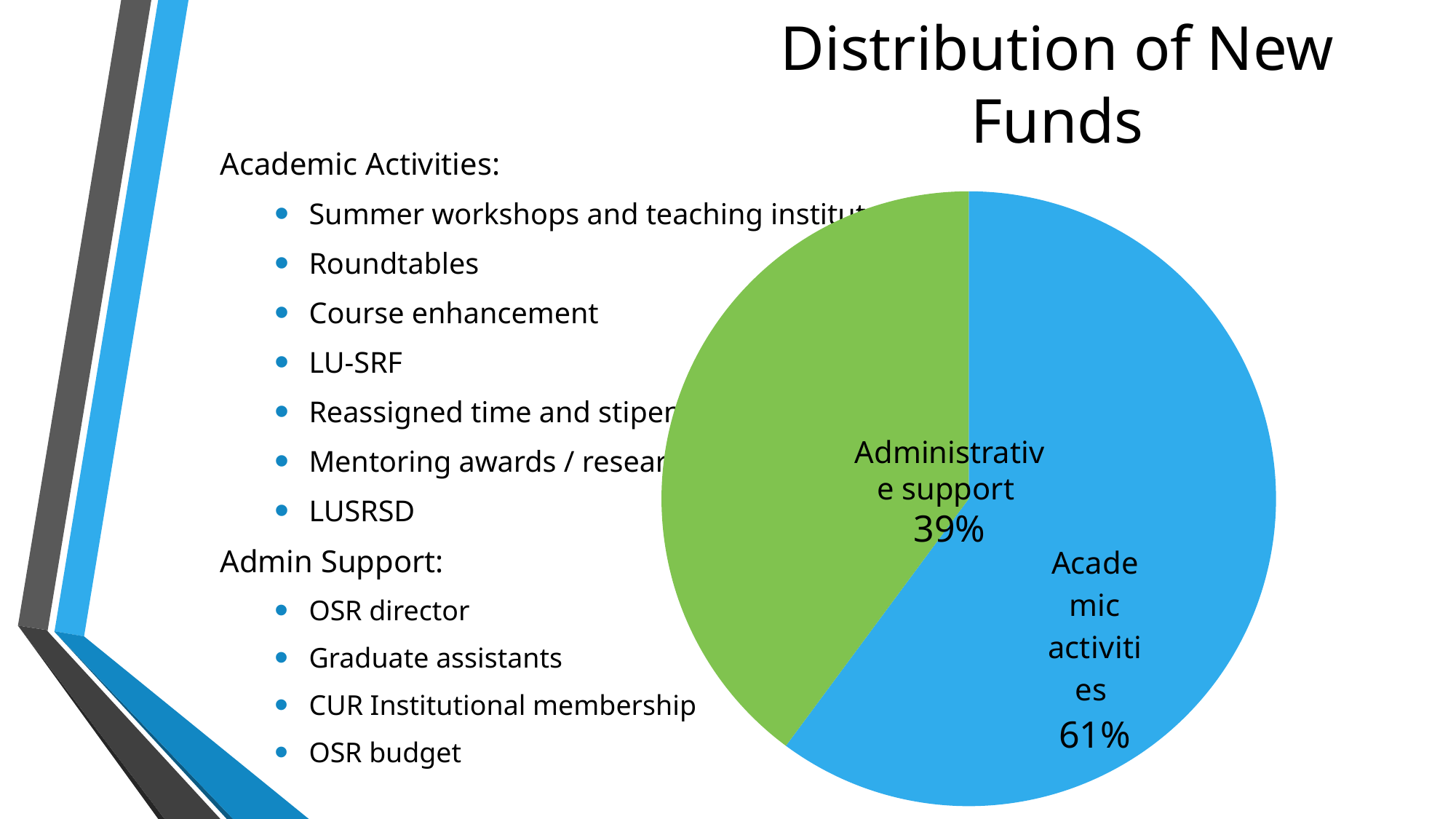
What is the difference in percentage points between the Academic activities and Administrative support slices? 22 What kind of chart is shown on the slide? Pie chart What is the title of the chart? Distribution of New Funds What colour is the Administrative support slice? Green What share of new funds goes to Academic activities? 61% Is the share for Academic activities greater or less than 50%? greater How many slices does the pie chart have? 2 Which slice of the pie is the largest? Academic activities What share of new funds goes to Administrative support? 39% Which slice of the pie is the smallest? Administrative support Which is larger, the Academic activities slice or the Administrative support slice? Academic activities